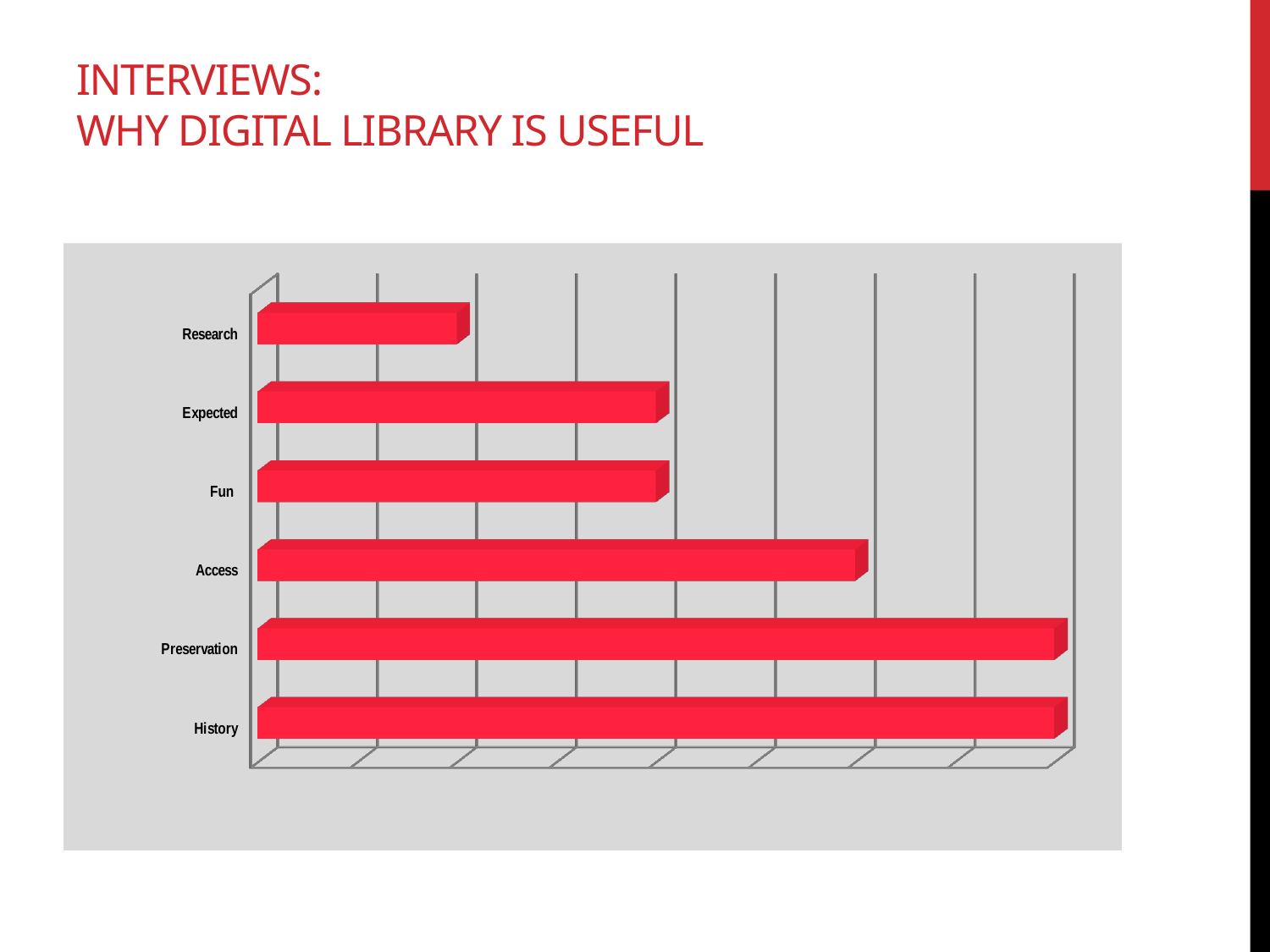
Which category has the lowest value in the chart? Research How many categories are plotted in the chart? 6 What colour are the bars in the chart? red Which is larger, the value for Access or the value for Fun? Access What is the title of the slide containing the chart? Interviews: Why Digital Library Is Useful Which is larger, the value for Access or the value for Research? Access What kind of chart is shown on the slide? bar chart Which is larger, the value for Expected or the value for Research? Expected